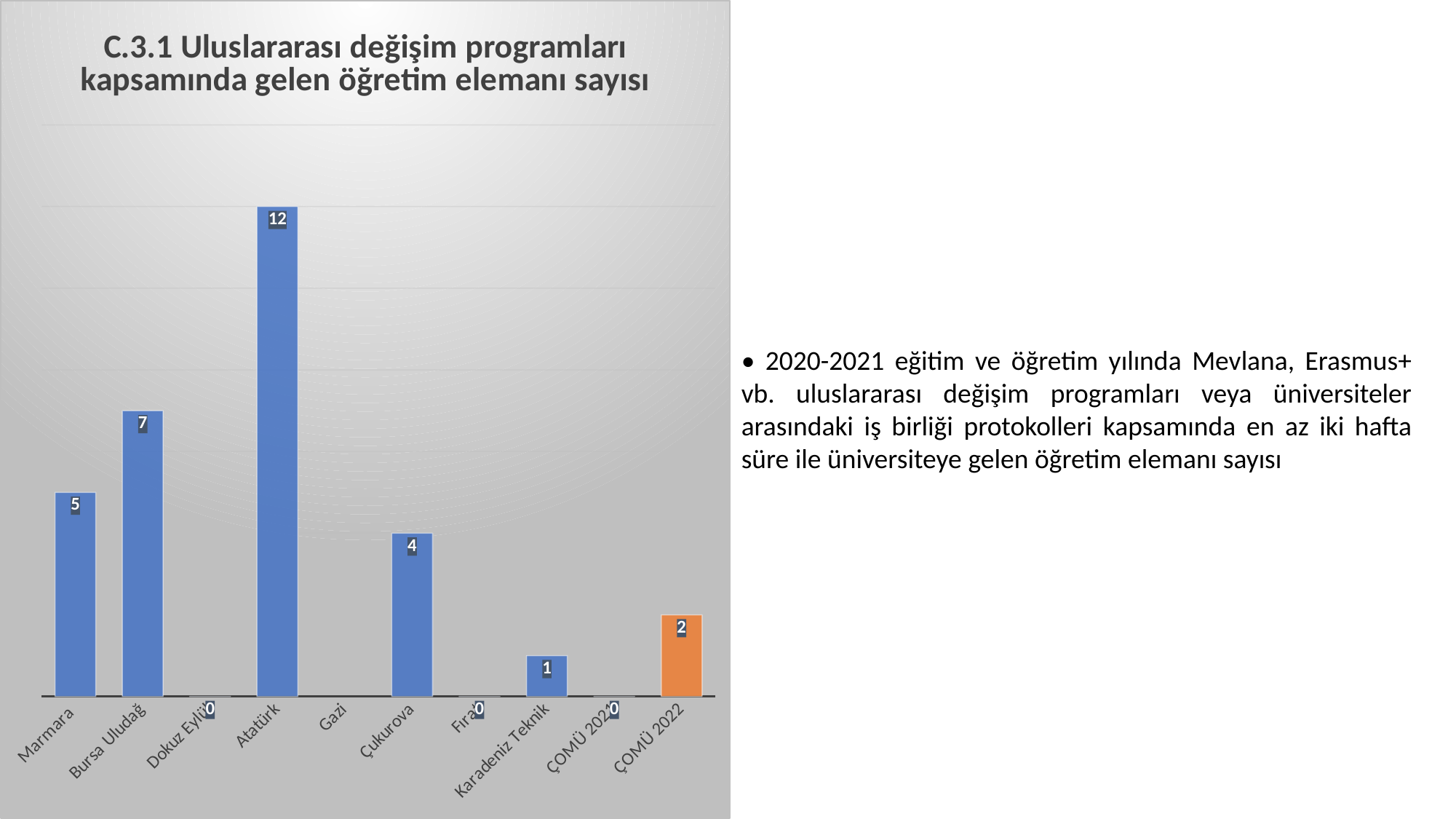
Which is larger, the value for Marmara or the value for Çukurova? Marmara What kind of chart is this? Bar chart Which category has the highest value? Atatürk What is the value for Çukurova? 4 What is the value for Karadeniz Teknik? 1 What is the value for Atatürk? 12 What is the value for Bursa Uludağ? 7 What is the value for Marmara? 5 What is the title of the chart? C.3.1 Uluslararası değişim programları kapsamında gelen öğretim elemanı sayısı How many categories are shown on the x axis? 10 What is the value for ÇOMÜ 2022? 2 What is the difference between the values for Atatürk and Bursa Uludağ? 5